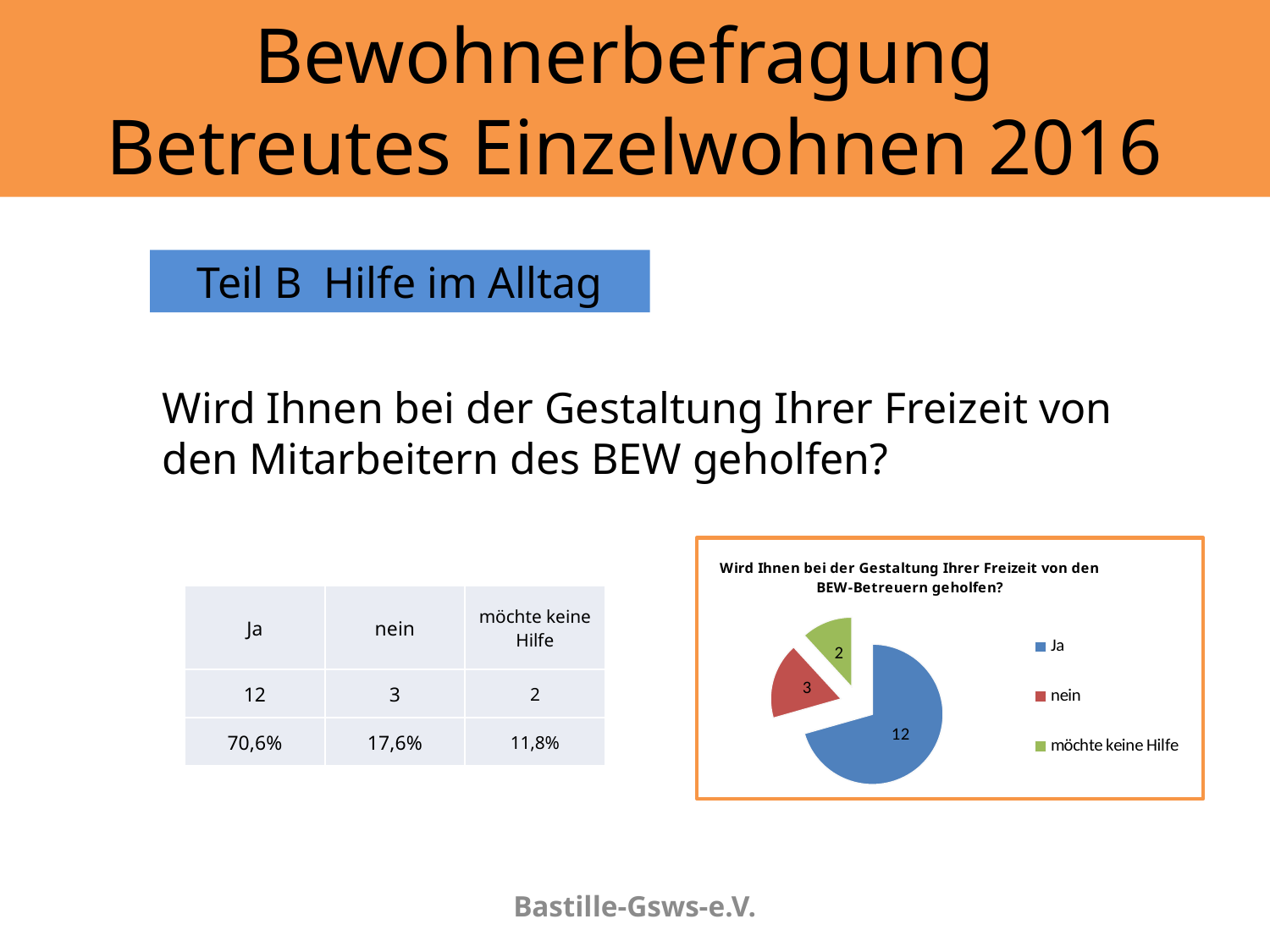
Which category has the largest slice in the pie chart? Ja How many entries does the legend of the pie chart list? 3 What kind of chart is shown on the slide? pie chart What is the value for "Ja" in the pie chart? 12 What is the total of all slices in the pie chart? 17 Which category has the smallest slice in the pie chart? möchte keine Hilfe What is the difference between the values for "Ja" and "nein" in the pie chart? 9 What colour is the "Ja" slice in the pie chart? blue What is the value for "nein" in the pie chart? 3 Which is larger in the pie chart, the value for "nein" or for "möchte keine Hilfe"? nein How many slices does the pie chart have? 3 What is the value for "möchte keine Hilfe" in the pie chart? 2